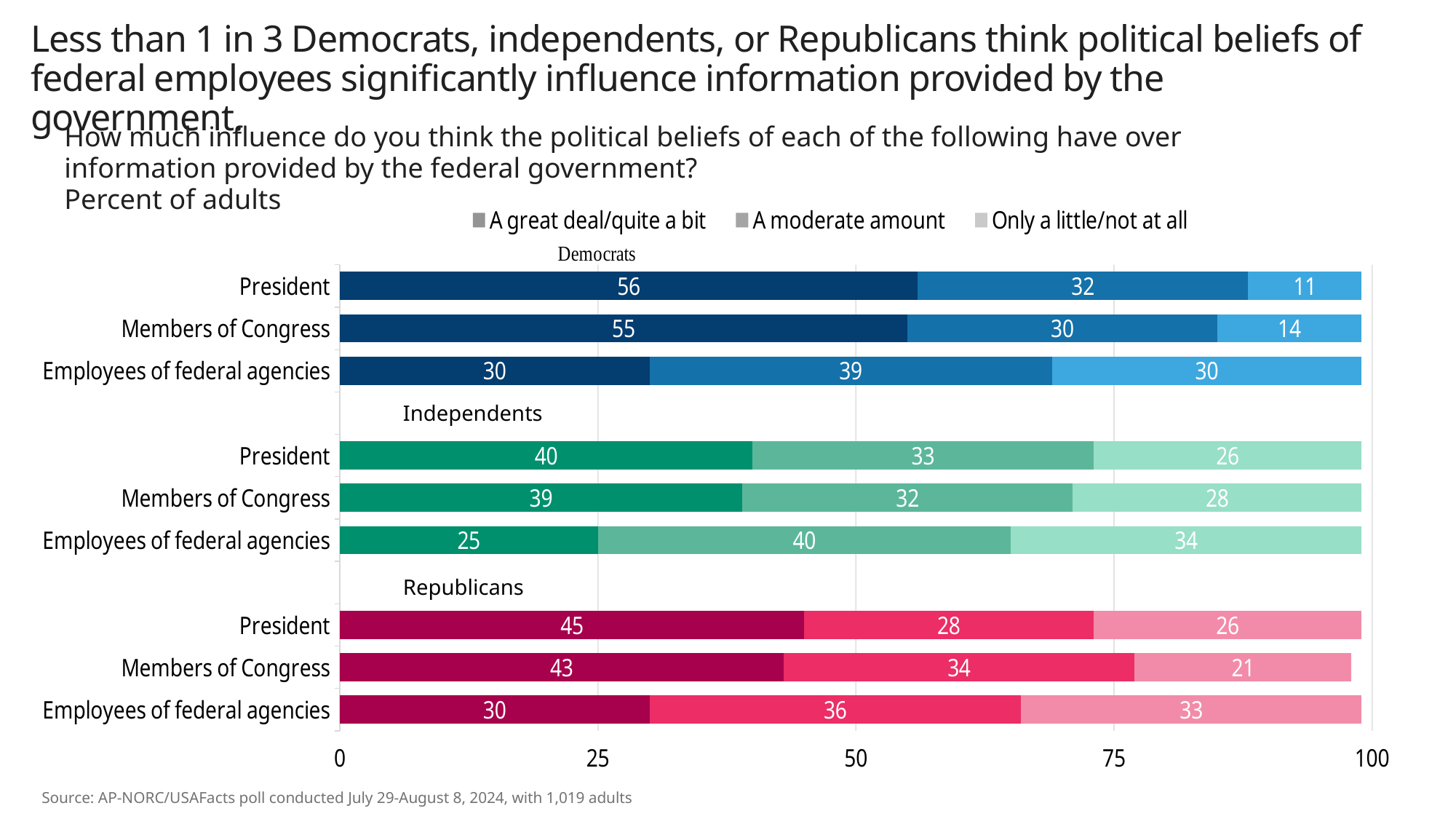
What is the total of the stacked bar for the President among Democrats? 99 What percentage of Democrats say the political beliefs of the President have a great deal/quite a bit of influence? 56 What kind of chart is shown on the slide? Stacked bar chart How many bars are plotted in the chart? 9 What percentage of independents say the political beliefs of employees of federal agencies have only a little/not at all influence? 34 Among independents, which category has the lowest 'A great deal/quite a bit' value? Employees of federal agencies Which is larger: the 'A moderate amount' value for employees of federal agencies among independents or among Republicans? Independents What percentage of Republicans say the political beliefs of members of Congress have a moderate amount of influence? 34 Among Democrats, which category has the lowest 'A great deal/quite a bit' value? Employees of federal agencies How many series does the legend list? 3 What is the difference between the 'A great deal/quite a bit' value for the President among Democrats and among Republicans? 11 Among Republicans, which category has the highest 'A great deal/quite a bit' value? President